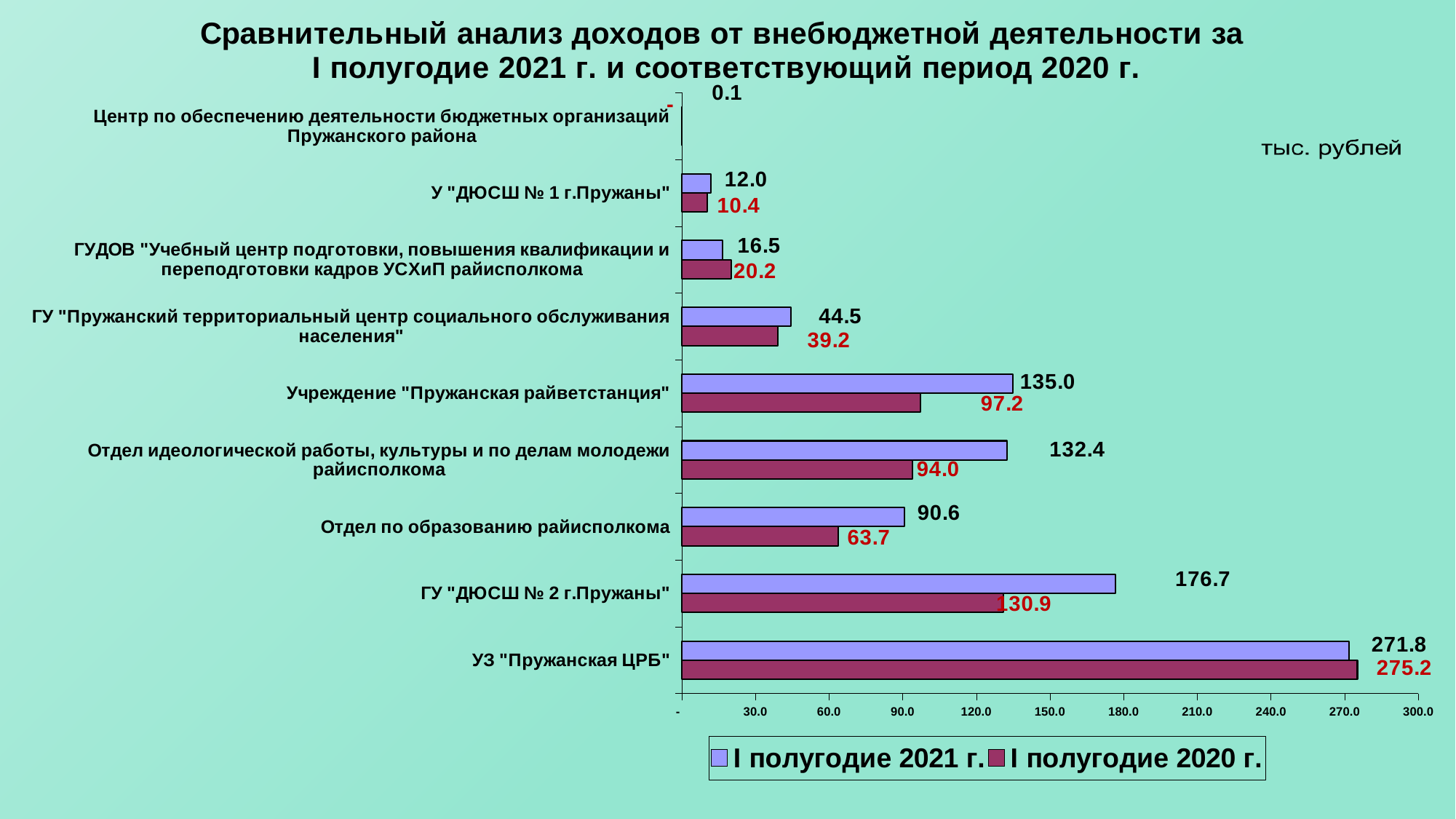
What is the value for УЗ "Пружанская ЦРБ" in the I полугодие 2021 г. series? 271.8 What kind of chart is shown on the slide? Bar chart Which category has the lowest value in the I полугодие 2021 г. series? Центр по обеспечению деятельности бюджетных организаций Пружанского района What is the difference between the I полугодие 2020 г. and I полугодие 2021 г. values for УЗ "Пружанская ЦРБ"? 3.4 What is the value for ГУ "ДЮСШ № 2 г.Пружаны" in the I полугодие 2020 г. series? 130.9 How many series does the legend list? 2 What is the value for Учреждение "Пружанская райветстанция" in the I полугодие 2020 г. series? 97.2 Which category has the highest value in the I полугодие 2021 г. series? УЗ "Пружанская ЦРБ" For ГУДОВ "Учебный центр подготовки, повышения квалификации и переподготовки кадров УСХиП райисполкома", which series has the larger value: I полугодие 2021 г. or I полугодие 2020 г.? I полугодие 2020 г. How many categories (organizations) are shown on the chart? 9 What is the difference between the I полугодие 2021 г. and I полугодие 2020 г. values for ГУ "ДЮСШ № 2 г.Пружаны"? 45.8 What is the value for Отдел по образованию райисполкома in the I полугодие 2021 г. series? 90.6